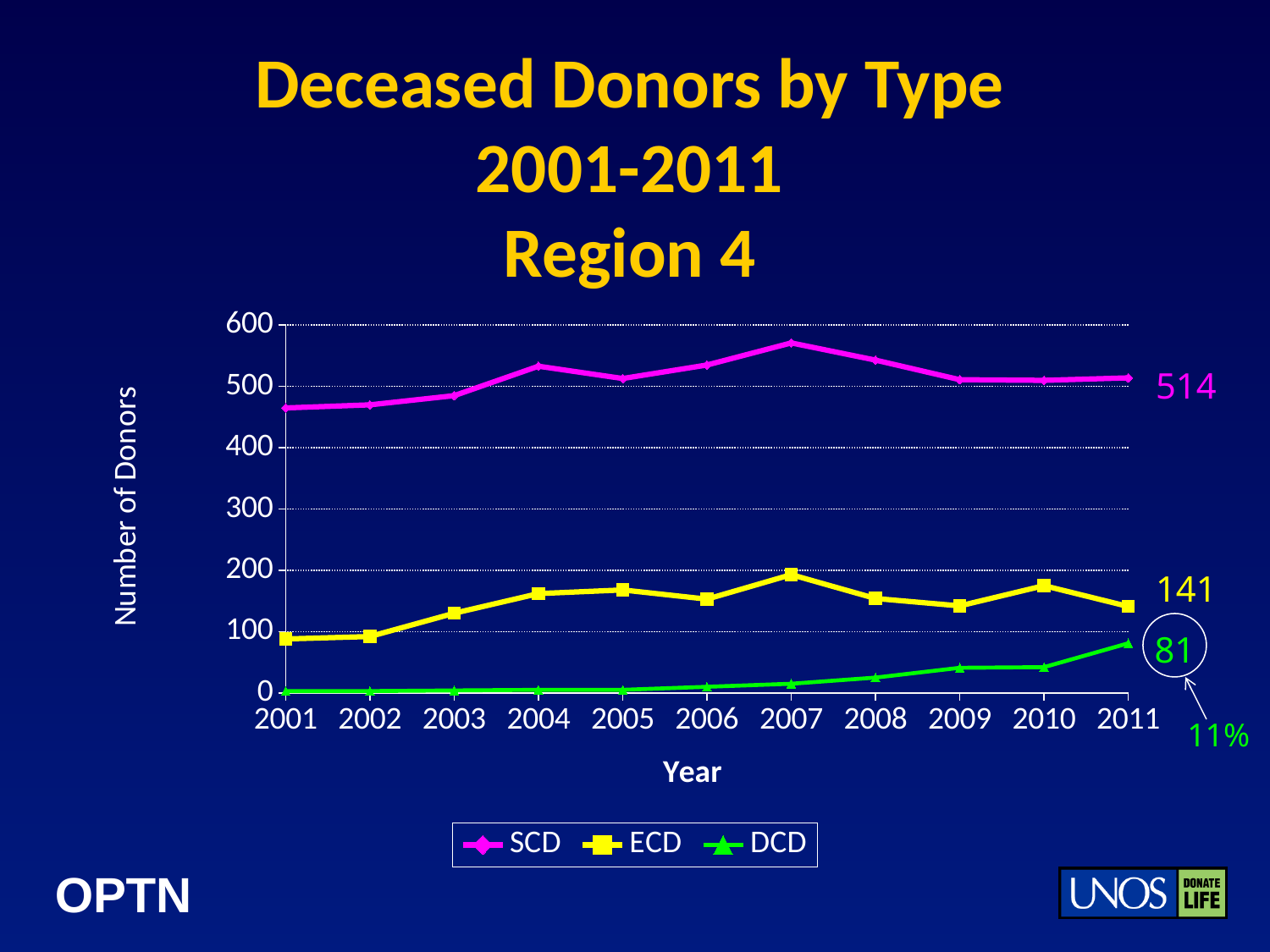
Which series has the higher value in 2011, SCD or ECD? SCD Is the value for ECD in 2001 greater or less than 100? less Is the value for SCD in 2007 greater or less than 500? greater What kind of chart is shown on the slide? Line chart How many years are plotted on the x axis? 11 What is the difference between the SCD and ECD values in 2011? 373 What is the value for DCD in 2011? 81 What is the difference between the ECD and DCD values in 2011? 60 Does the DCD series rise or fall from 2001 to 2011? Rise How many series does the legend list? 3 What is the value for SCD in 2011? 514 What is the value for ECD in 2011? 141